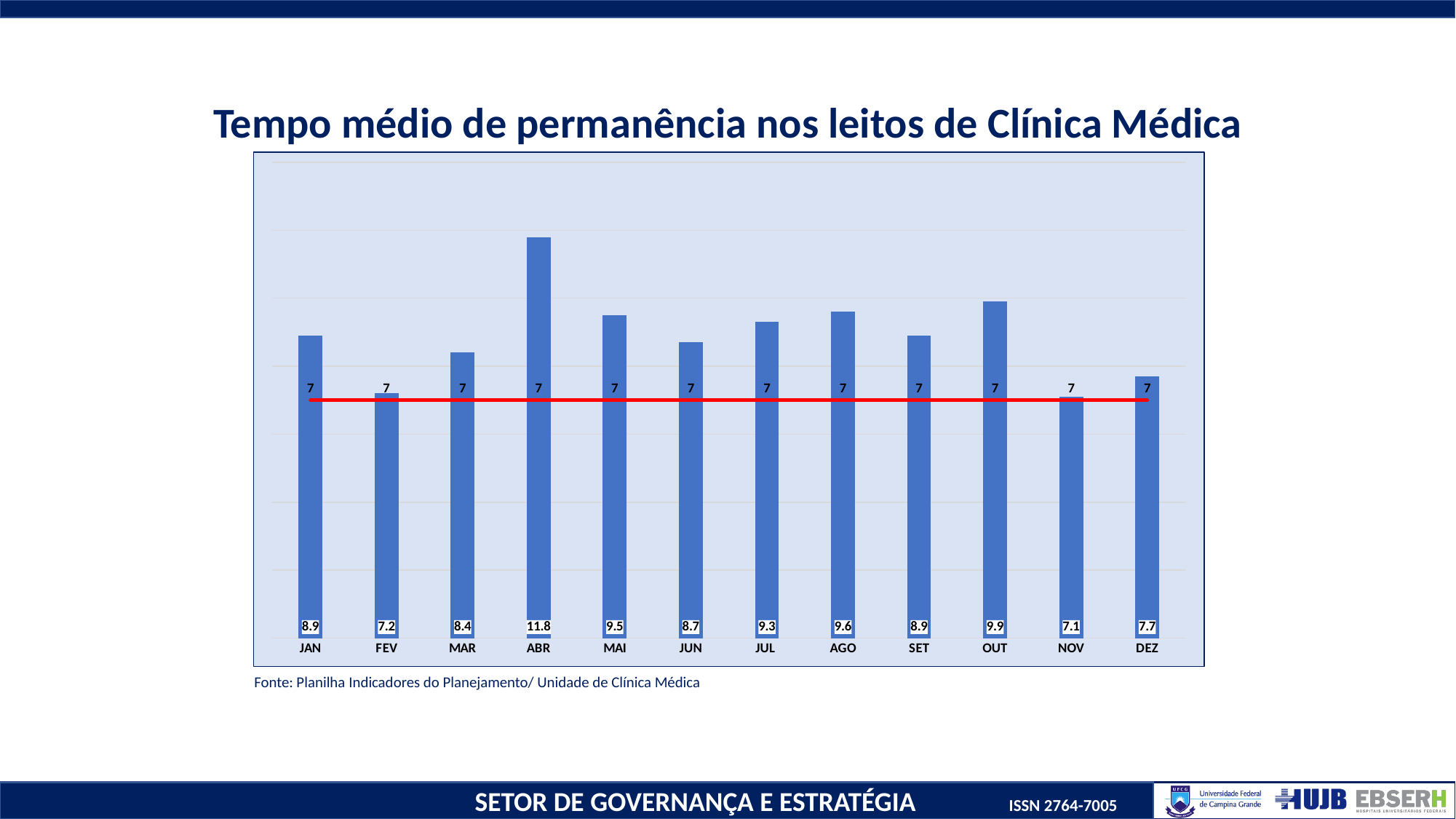
What is the value for NOV? 7.1 What is the difference between the values for OUT and SET? 1.0 What kind of chart is this? combination bar and line chart Which is larger, the value for MAI or the value for JUL? MAI What is the value for ABR? 11.8 What is the value for OUT? 9.9 What is the difference between the values for ABR and FEV? 4.6 Which month has the highest bar? ABR What value does the red horizontal line represent across all months? 7 How many months are shown on the x axis? 12 What is the title of the chart? Tempo médio de permanência nos leitos de Clínica Médica Which month has the lowest bar? NOV